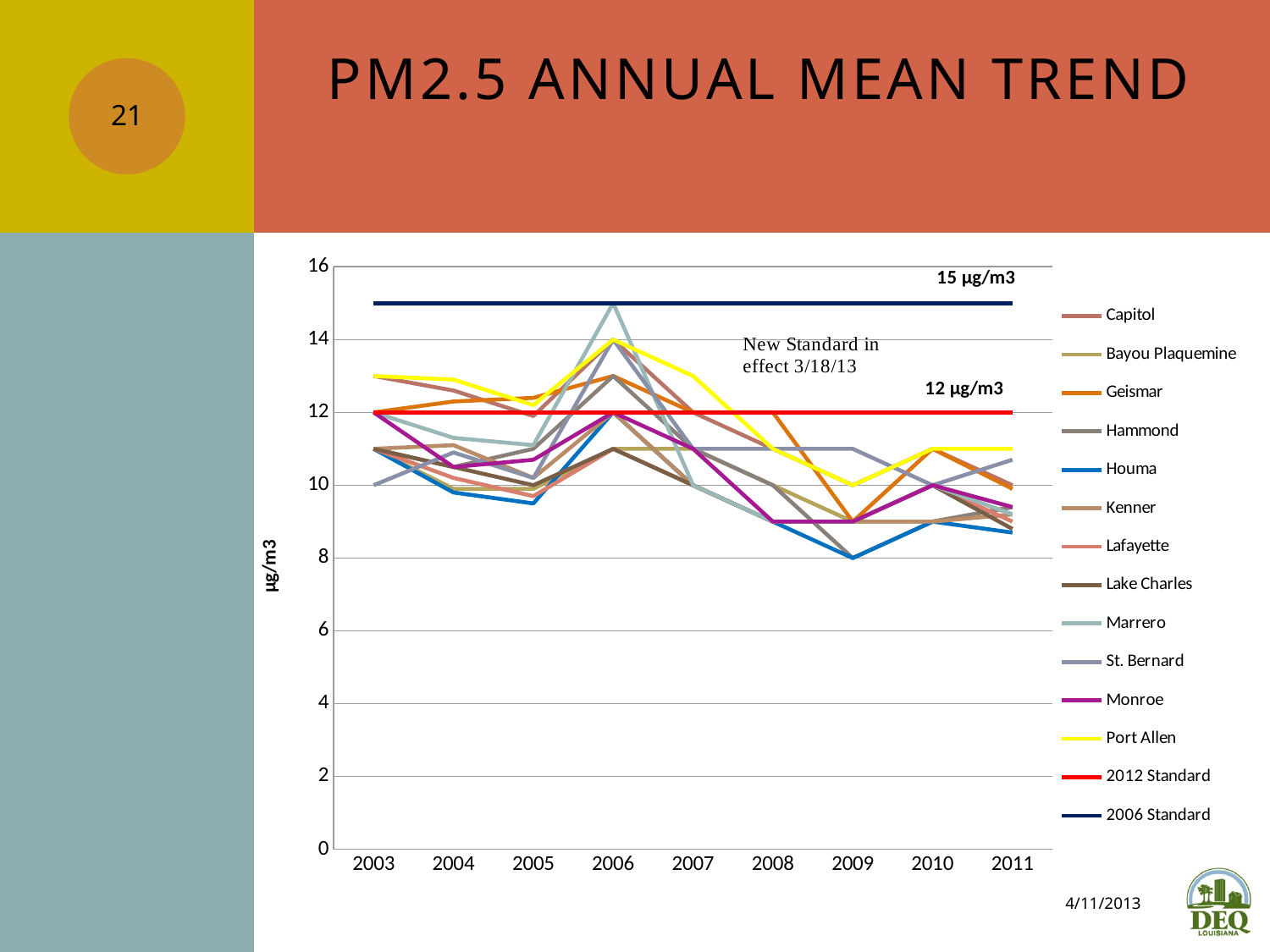
Is the value for Houma in 2009 greater or less than 10? less What is the difference between the 2006 Standard and the 2012 Standard? 3 µg/m3 What value is labelled for the 2012 Standard line? 12 µg/m3 Does the Houma line rise or fall from 2003 to 2009? fall Is the value for Marrero in 2006 greater or less than 14? greater What kind of chart is shown on the slide? line chart Which is higher, the 2006 Standard or the 2012 Standard? 2006 Standard What value is labelled for the 2006 Standard line? 15 µg/m3 How many series does the legend list? 14 How many years are shown on the x axis? 9 What is the label on the y axis? µg/m3 In which year does the Marrero line reach its highest value? 2006